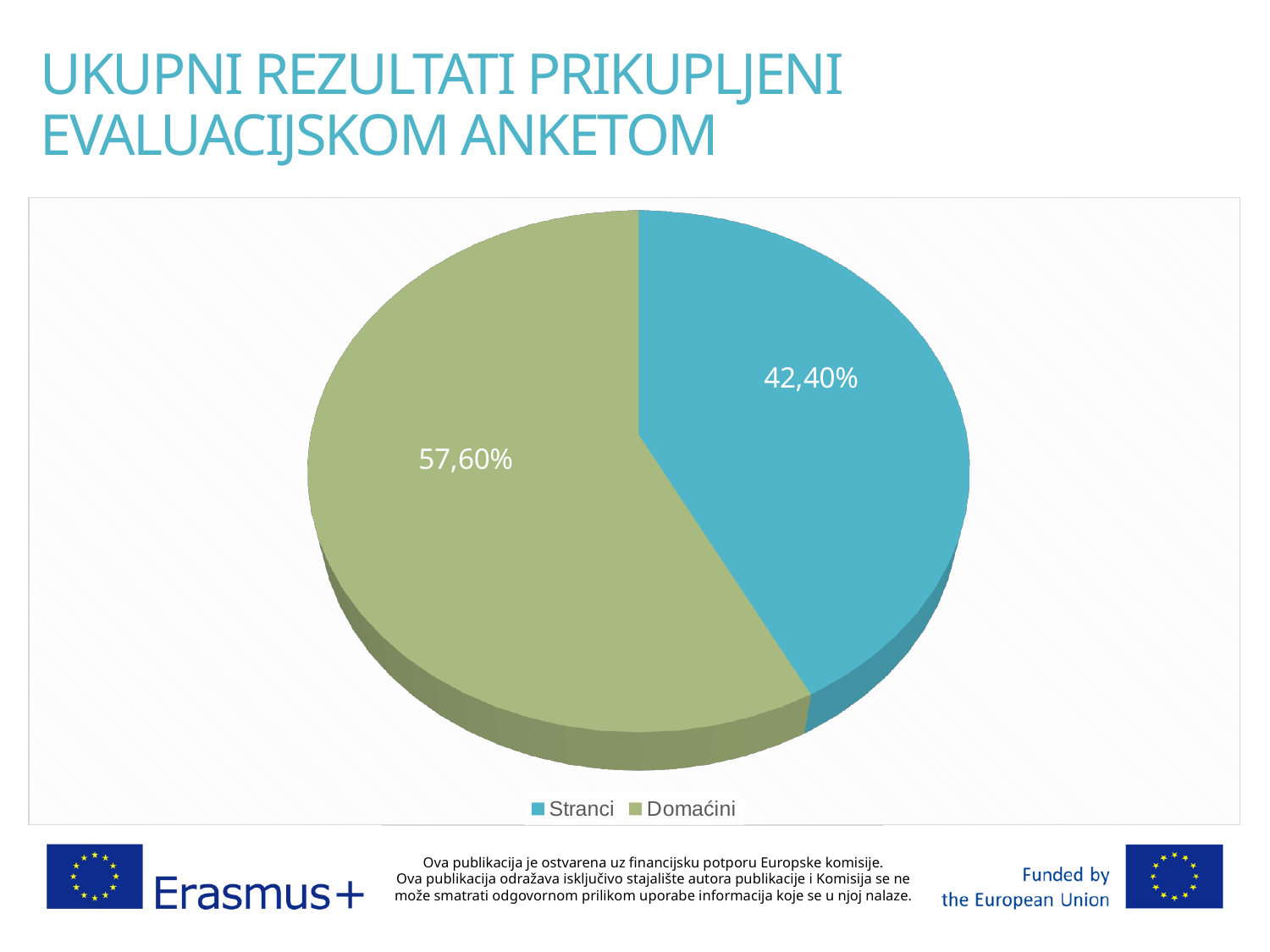
What colour is the Stranci slice? Blue How many entries does the legend list? 2 Which category has the smallest slice of the pie? Stranci Which category has the largest slice of the pie? Domaćini Which slice is larger, Stranci or Domaćini? Domaćini What is the difference in percentage points between the Domaćini and Stranci slices? 15,20% What kind of chart is shown on the slide? Pie chart What share of the pie does Domaćini represent? 57,60% What share of the pie does Stranci represent? 42,40% What colour is the Domaćini slice? Green How many categories does the pie chart have? 2